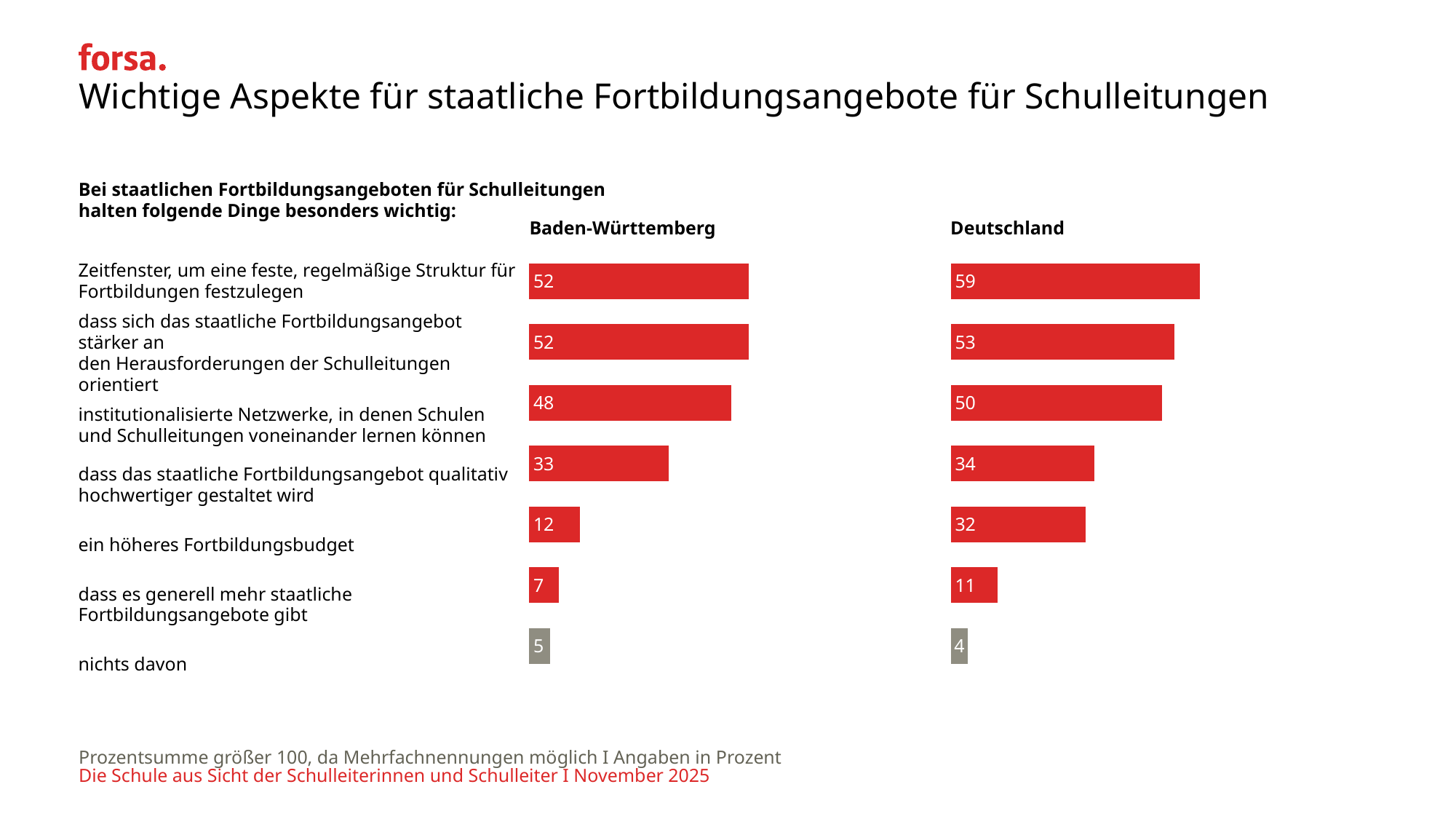
How many categories are shown in the Baden-Württemberg chart? 7 In the Baden-Württemberg chart, what is the value for "institutionalisierte Netzwerke, in denen Schulen und Schulleitungen voneinander lernen können"? 48 In the Baden-Württemberg chart, which category has the lowest value? nichts davon In the Deutschland chart, what colour is the bar for "nichts davon"? grey In the Baden-Württemberg chart, what is the difference between the values for "Zeitfenster, um eine feste, regelmäßige Struktur für Fortbildungen festzulegen" and "dass das staatliche Fortbildungsangebot qualitativ hochwertiger gestaltet wird"? 19 For "dass es generell mehr staatliche Fortbildungsangebote gibt", which chart shows the larger value, Baden-Württemberg or Deutschland? Deutschland What kind of chart is used on this slide? bar chart What is the difference between the Deutschland and Baden-Württemberg values for "ein höheres Fortbildungsbudget"? 20 In the Baden-Württemberg chart, what is the value for "ein höheres Fortbildungsbudget"? 12 In the Deutschland chart, what is the value for "ein höheres Fortbildungsbudget"? 32 In the Deutschland chart, what is the value for "Zeitfenster, um eine feste, regelmäßige Struktur für Fortbildungen festzulegen"? 59 In the Deutschland chart, which category has the highest value? Zeitfenster, um eine feste, regelmäßige Struktur für Fortbildungen festzulegen